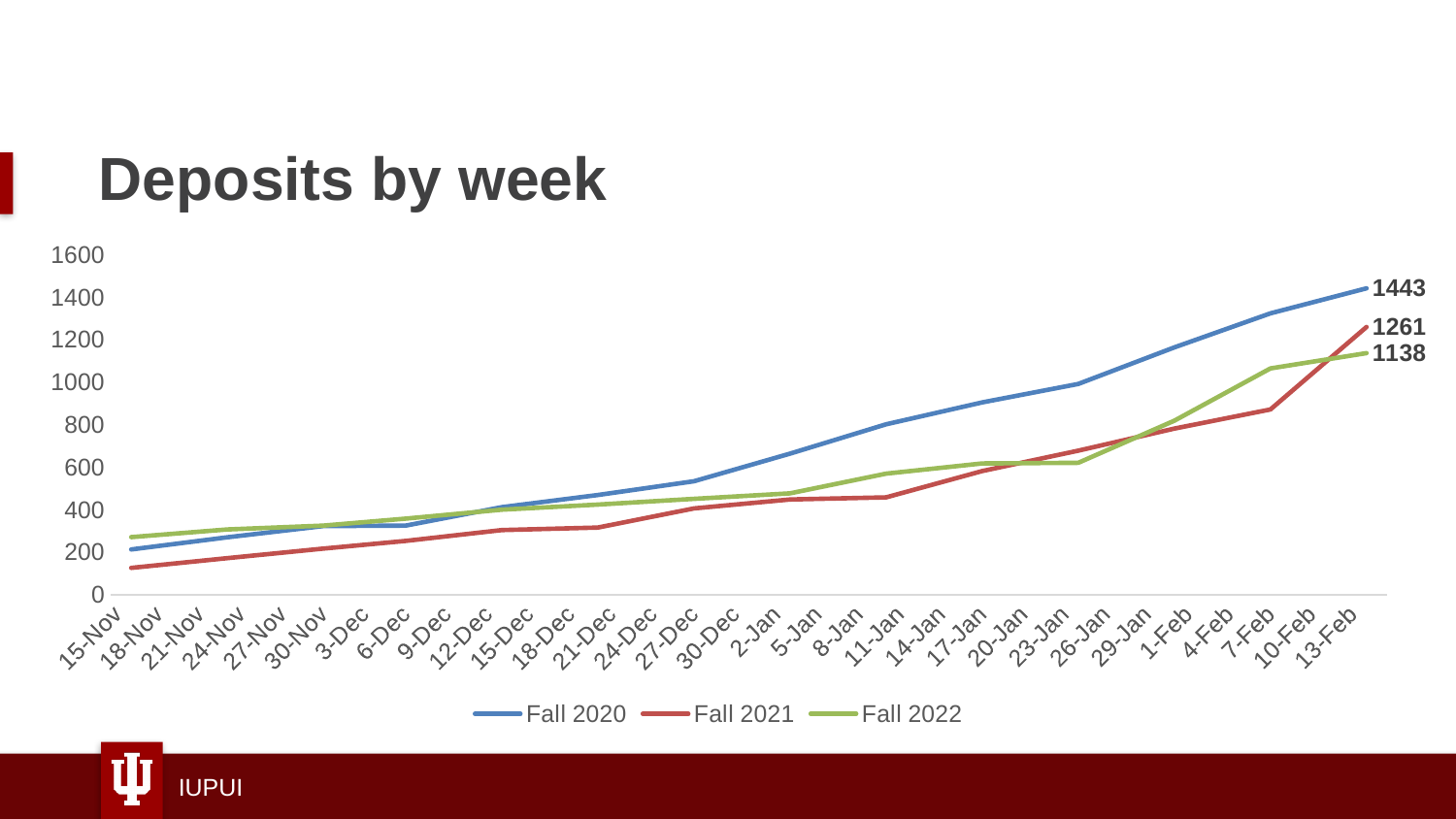
Do the Fall 2020 values rise or fall from 15-Nov to 13-Feb? Rise Which series has the highest value on 13-Feb? Fall 2020 What kind of chart is shown on the slide? Line chart What is the difference between the Fall 2021 and Fall 2022 values on 13-Feb? 123 How many series does the legend list? 3 What is the final value shown for Fall 2020 on 13-Feb? 1443 Is the value for Fall 2020 on 26-Jan greater or less than 800? greater What is the final value shown for Fall 2022 on 13-Feb? 1138 What is the final value shown for Fall 2021 on 13-Feb? 1261 Which series has the lowest value on 13-Feb? Fall 2022 On 13-Feb, which is larger: the Fall 2021 value or the Fall 2022 value? Fall 2021 What is the difference between the Fall 2020 and Fall 2021 values on 13-Feb? 182